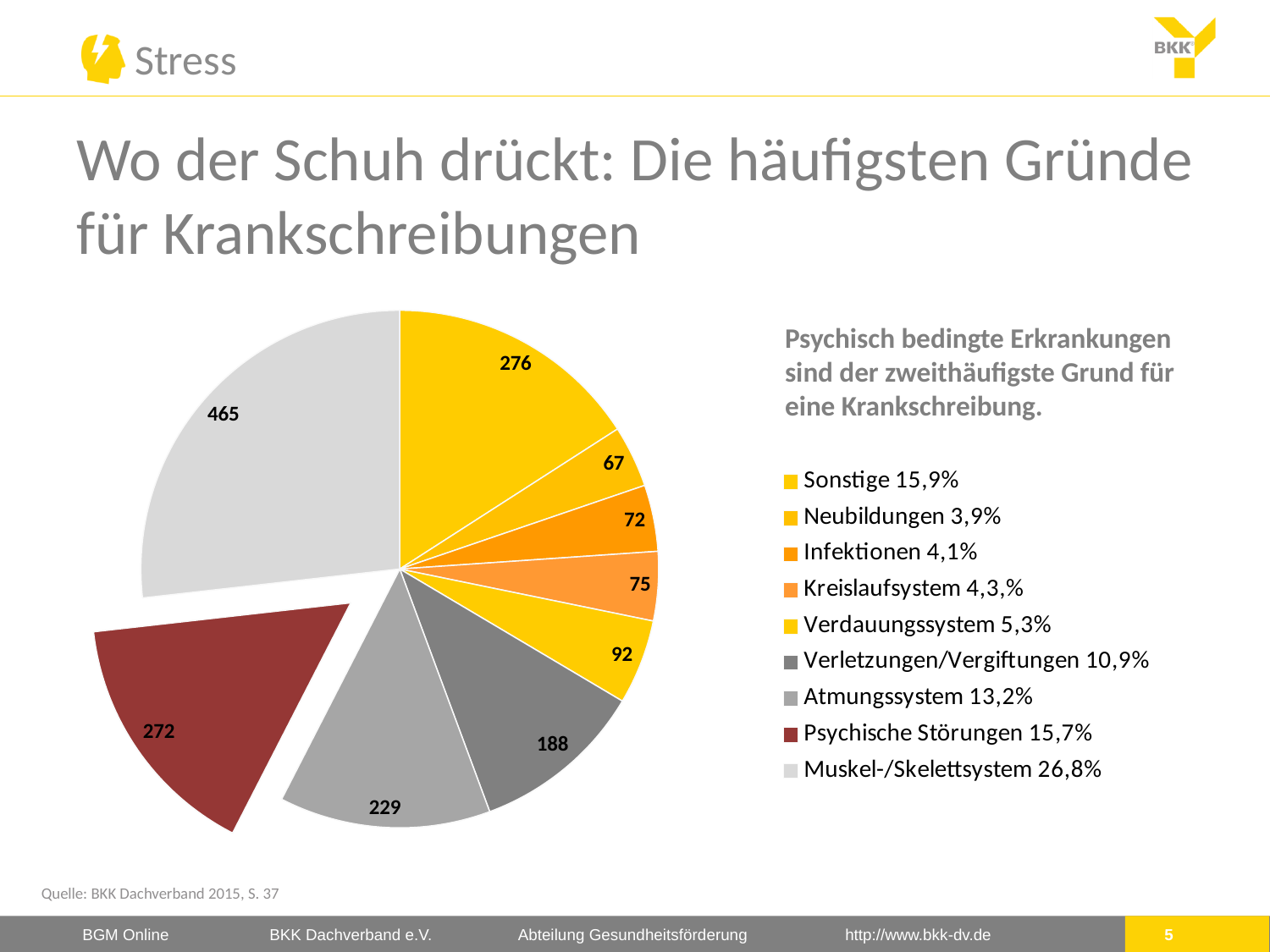
What is the source cited below the chart? BKK Dachverband 2015, S. 37 What is the value shown for Neubildungen? 67 What is the difference between the values for Muskel-/Skelettsystem and Psychische Störungen? 193 Which category has the largest slice in the pie chart? Muskel-/Skelettsystem What kind of chart is shown on the slide? pie chart How many slices does the pie chart have? 9 What share of the pie does Psychische Störungen represent according to the legend? 15,7% What is the value shown for Psychische Störungen? 272 What is the value shown for Atmungssystem? 229 What is the value shown for Muskel-/Skelettsystem? 465 Which is larger, the value for Sonstige or the value for Atmungssystem? Sonstige Which category has the smallest slice in the pie chart? Neubildungen